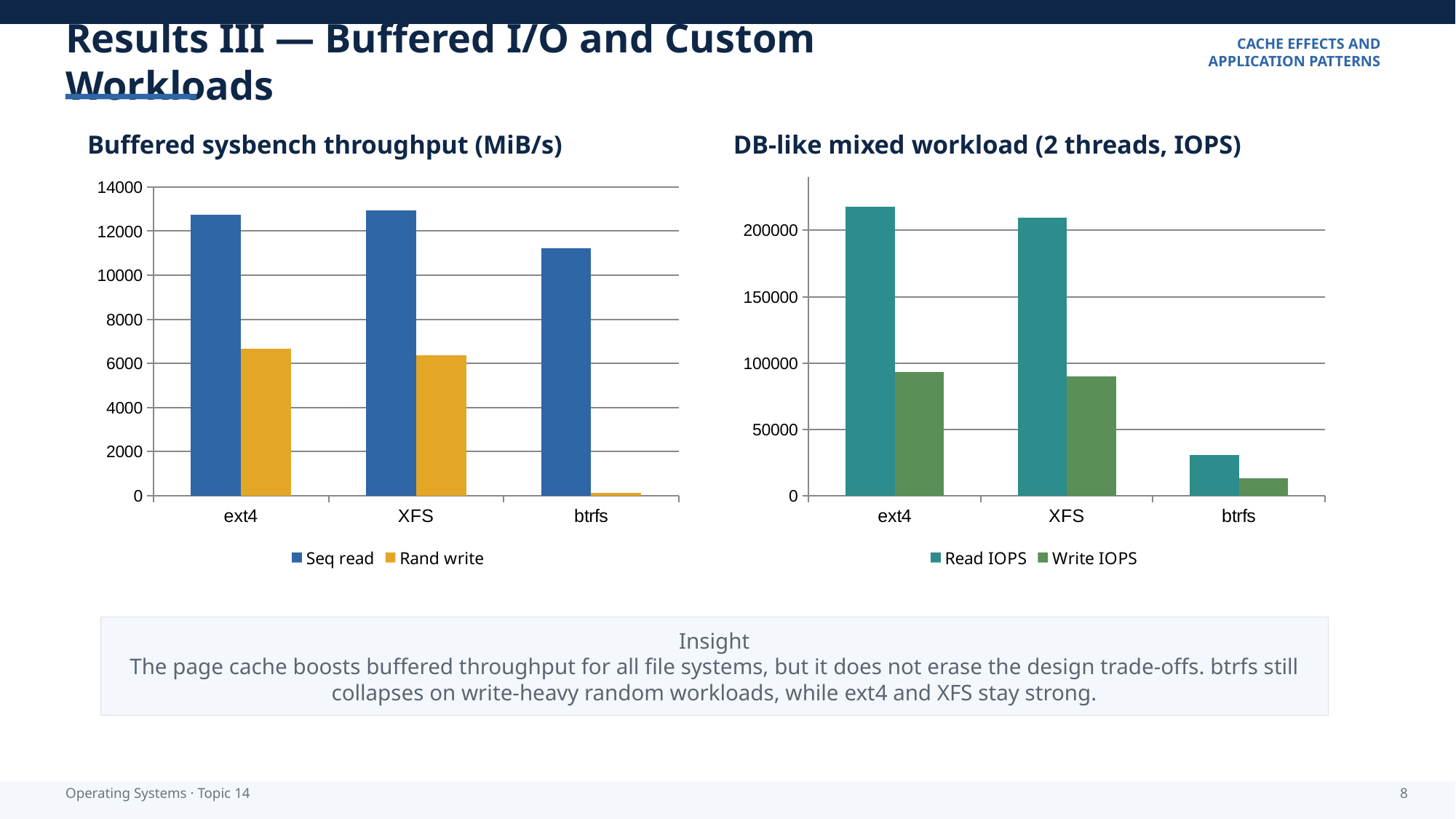
In the 'DB-like mixed workload (2 threads, IOPS)' chart, is the Read IOPS value for ext4 greater or less than 200000? greater In the 'DB-like mixed workload (2 threads, IOPS)' chart, which file system has the lowest Read IOPS? btrfs In the 'DB-like mixed workload (2 threads, IOPS)' chart, is the Read IOPS value for btrfs greater or less than 50000? less In the 'Buffered sysbench throughput (MiB/s)' chart, is the Rand write value for ext4 greater or less than 6000? greater What kind of chart is the 'DB-like mixed workload (2 threads, IOPS)' chart? Bar chart How many file systems are shown on the x axis of the 'DB-like mixed workload (2 threads, IOPS)' chart? 3 In the 'Buffered sysbench throughput (MiB/s)' chart, which file system has the lowest Rand write value? btrfs In the 'Buffered sysbench throughput (MiB/s)' chart, which is larger for XFS: Seq read or Rand write? Seq read How many series does the legend of the 'Buffered sysbench throughput (MiB/s)' chart list? 2